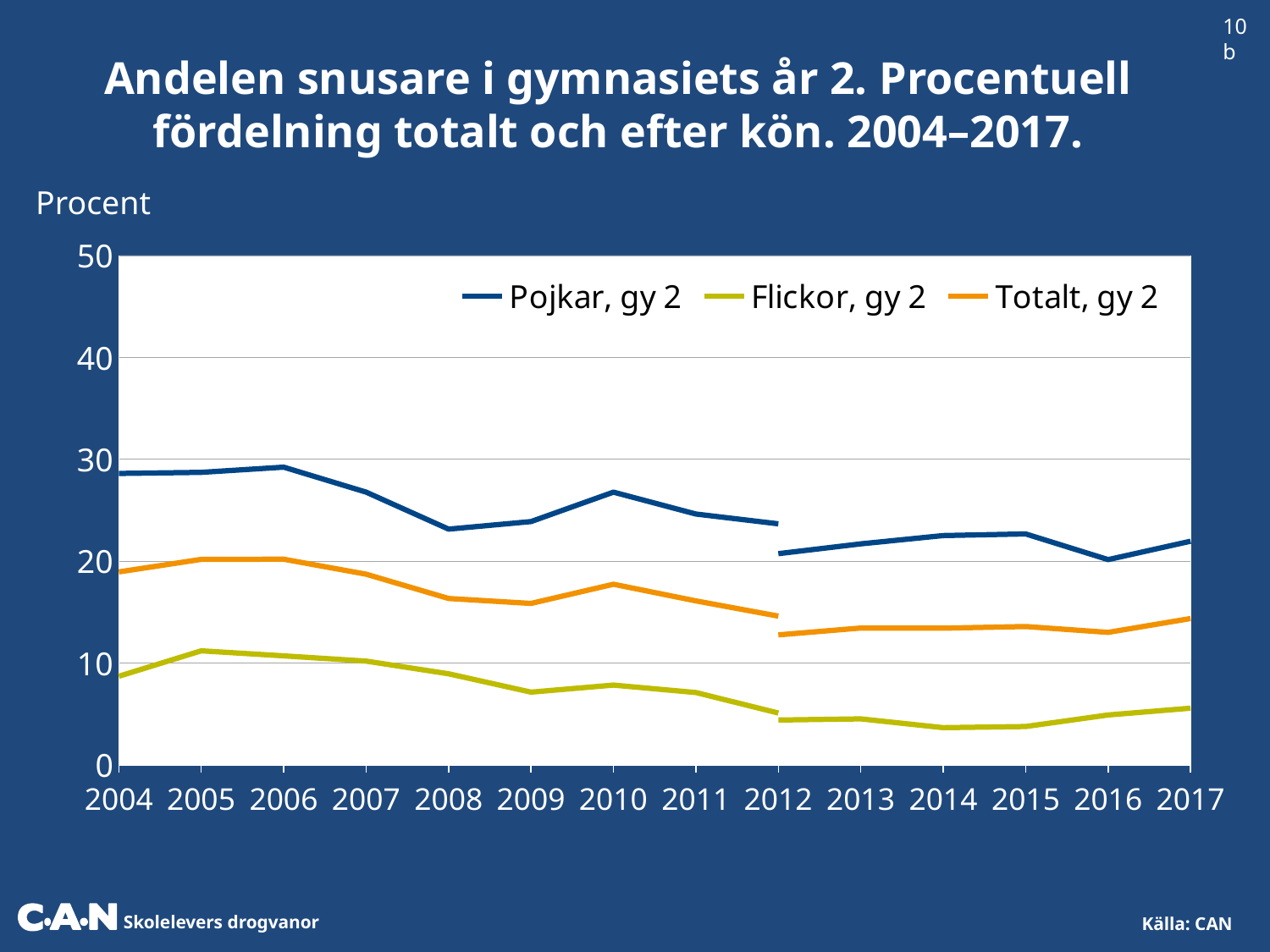
What colour is the line for Totalt, gy 2? orange Is the value for Flickor, gy 2 in 2014 greater or less than 10? less Is the value for Totalt, gy 2 in 2016 greater or less than 10? greater What kind of chart is shown on the slide? line chart Is the value for Pojkar, gy 2 in 2006 greater or less than 20? greater How many years are shown on the x axis? 14 Which series has the highest values throughout the chart? Pojkar, gy 2 Do the values for Pojkar, gy 2 generally rise or fall from 2004 to 2017? fall Which series has the lowest values throughout the chart? Flickor, gy 2 How many series does the legend list? 3 Which is larger in 2010: the value for Pojkar, gy 2 or Flickor, gy 2? Pojkar, gy 2